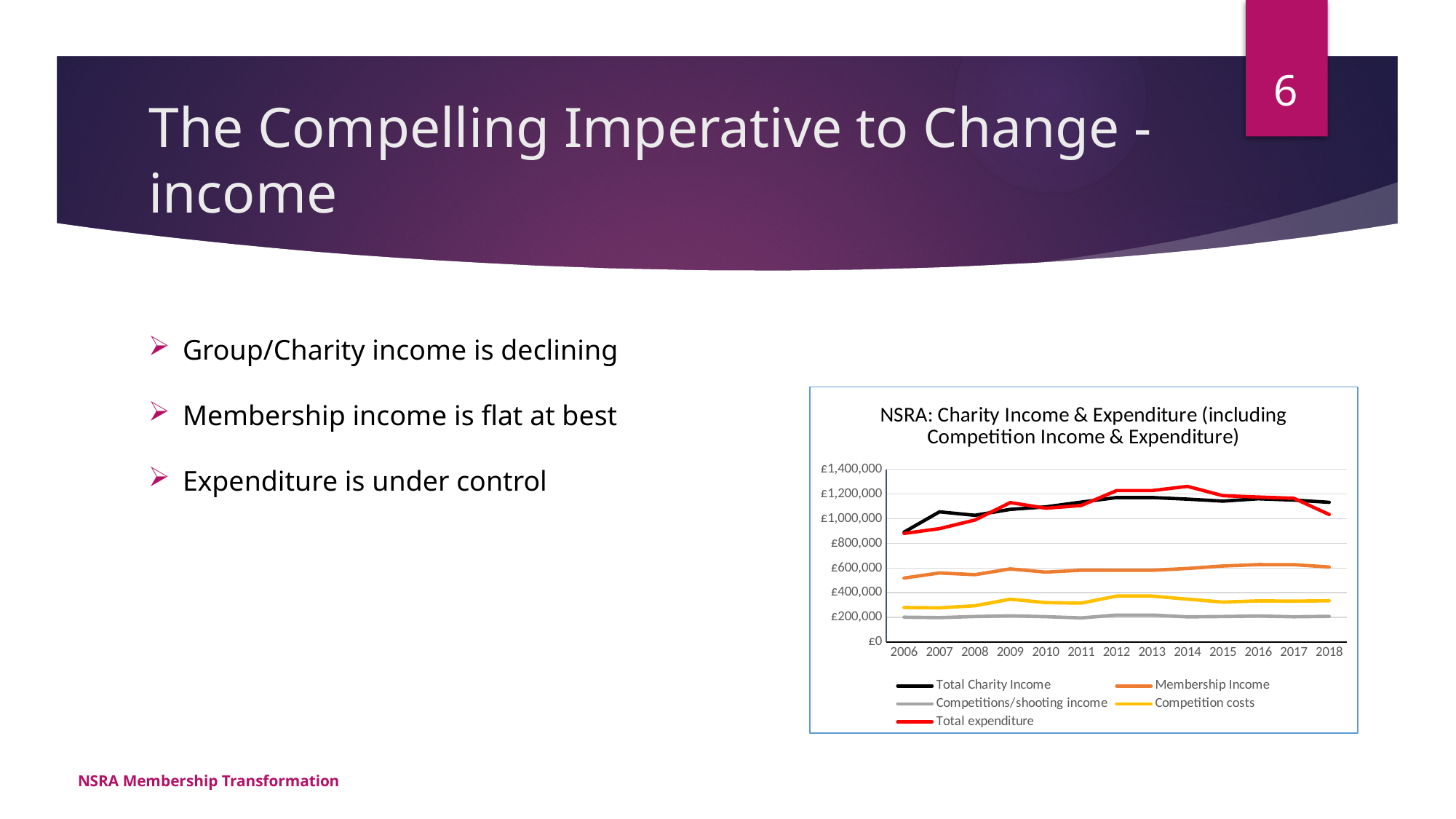
Does Total expenditure rise or fall from 2014 to 2018? Fall What kind of chart is shown on the slide? Line chart How many years are plotted along the x axis of the chart? 13 Is the value for Competitions/shooting income in 2012 greater or less than £400,000? less Is the value for Total expenditure in 2014 greater or less than £1,200,000? greater Is the value for Competition costs in 2009 greater or less than £400,000? less In which year does Total expenditure reach its highest value? 2014 Which series has the lowest values across all years on the chart? Competitions/shooting income How many series does the chart's legend list? 5 What is the title of the chart? NSRA: Charity Income & Expenditure (including Competition Income & Expenditure) In 2018, which is larger: Total Charity Income or Total expenditure? Total Charity Income